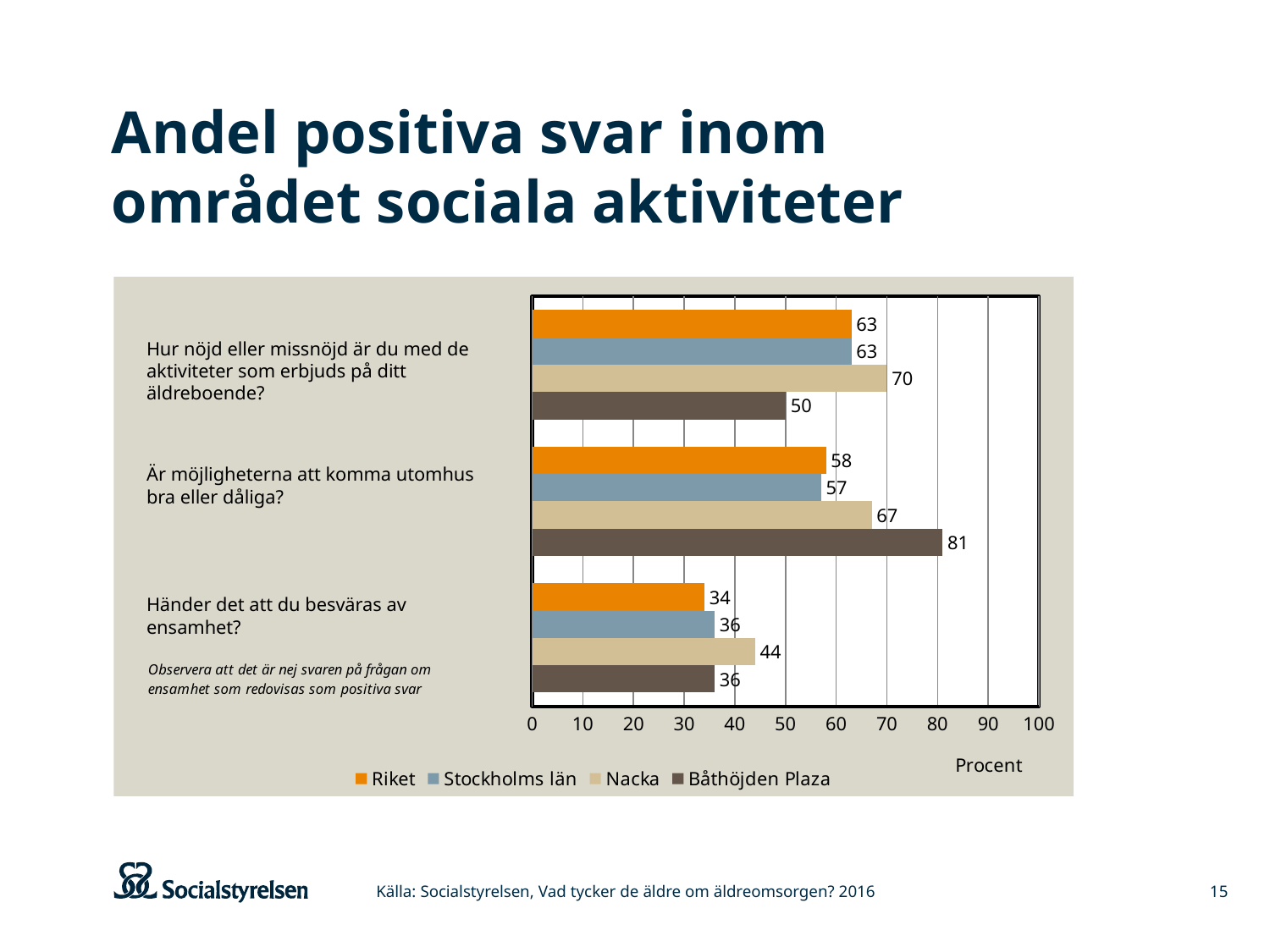
How many questions (categories) are shown on the chart? 3 What is the value for Nacka on the question "Hur nöjd eller missnöjd är du med de aktiviteter som erbjuds på ditt äldreboende?"? 70 Which series has the highest value on the question "Är möjligheterna att komma utomhus bra eller dåliga?"? Båthöjden Plaza What kind of chart is shown on the slide? bar chart How many series does the legend list? 4 What is the difference between the Nacka and Båthöjden Plaza values on the question "Hur nöjd eller missnöjd är du med de aktiviteter som erbjuds på ditt äldreboende?"? 20 What is the value for Riket on the question "Händer det att du besväras av ensamhet?"? 34 Is the value for Båthöjden Plaza on the question "Är möjligheterna att komma utomhus bra eller dåliga?" greater or less than 80? greater What is the value for Båthöjden Plaza on the question "Är möjligheterna att komma utomhus bra eller dåliga?"? 81 What unit label is shown on the horizontal axis of the chart? Procent Which is larger on the question "Händer det att du besväras av ensamhet?": the value for Nacka or the value for Stockholms län? Nacka Which series has the lowest value on the question "Hur nöjd eller missnöjd är du med de aktiviteter som erbjuds på ditt äldreboende?"? Båthöjden Plaza